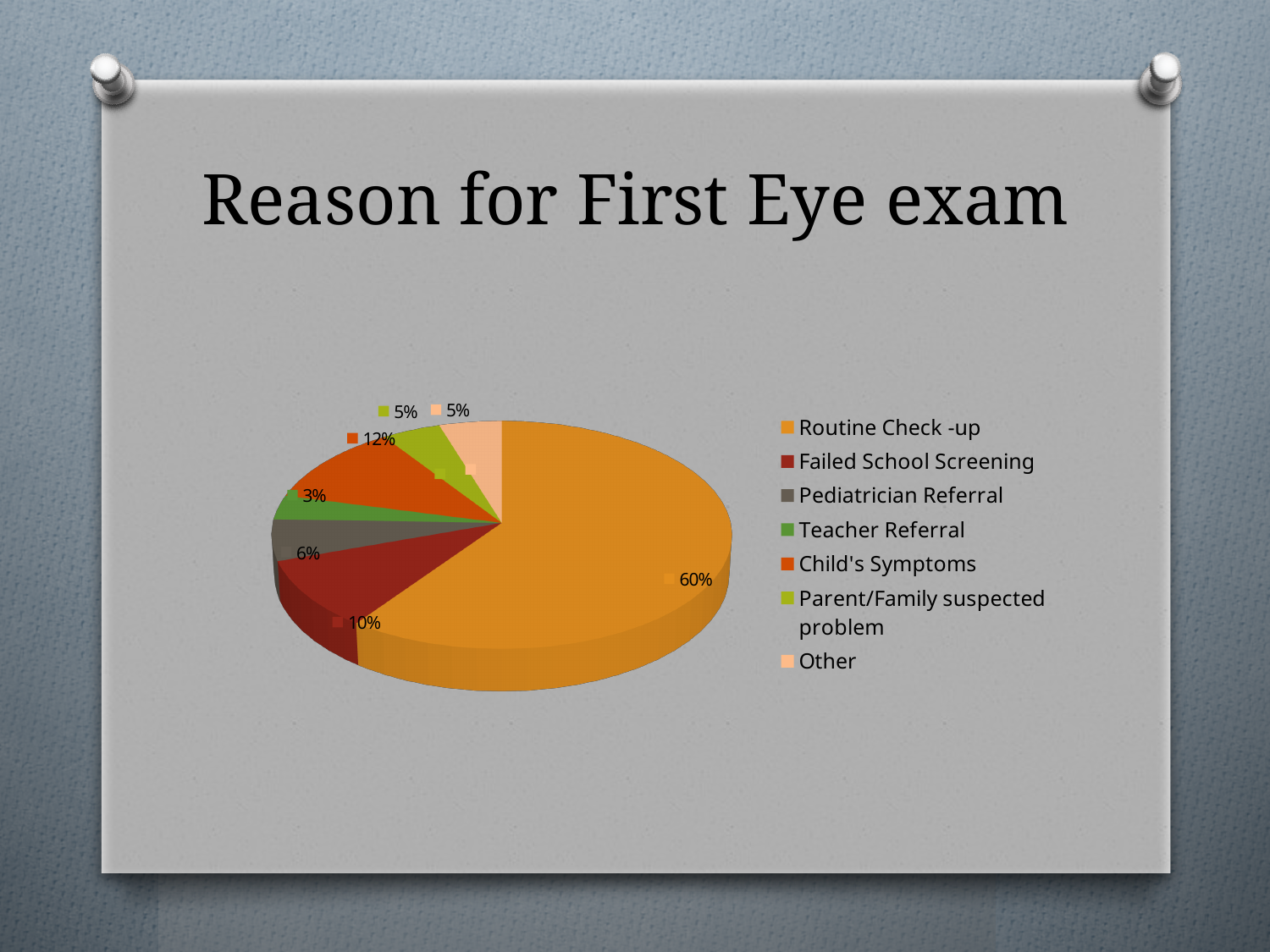
What percentage is shown for Teacher Referral? 3% What share of the pie is Routine Check-up? 60% What type of chart is shown on the slide? Pie chart What is the difference in percentage points between Child's Symptoms and Failed School Screening? 2 What percentage is shown for Failed School Screening? 10% What is the title of the slide containing the chart? Reason for First Eye exam Which is larger, Pediatrician Referral or Teacher Referral? Pediatrician Referral Which category has the smallest slice of the pie? Teacher Referral How many categories does the legend list? 7 What percentage is shown for Pediatrician Referral? 6% What percentage is shown for Child's Symptoms? 12% Which category has the largest slice of the pie? Routine Check-up